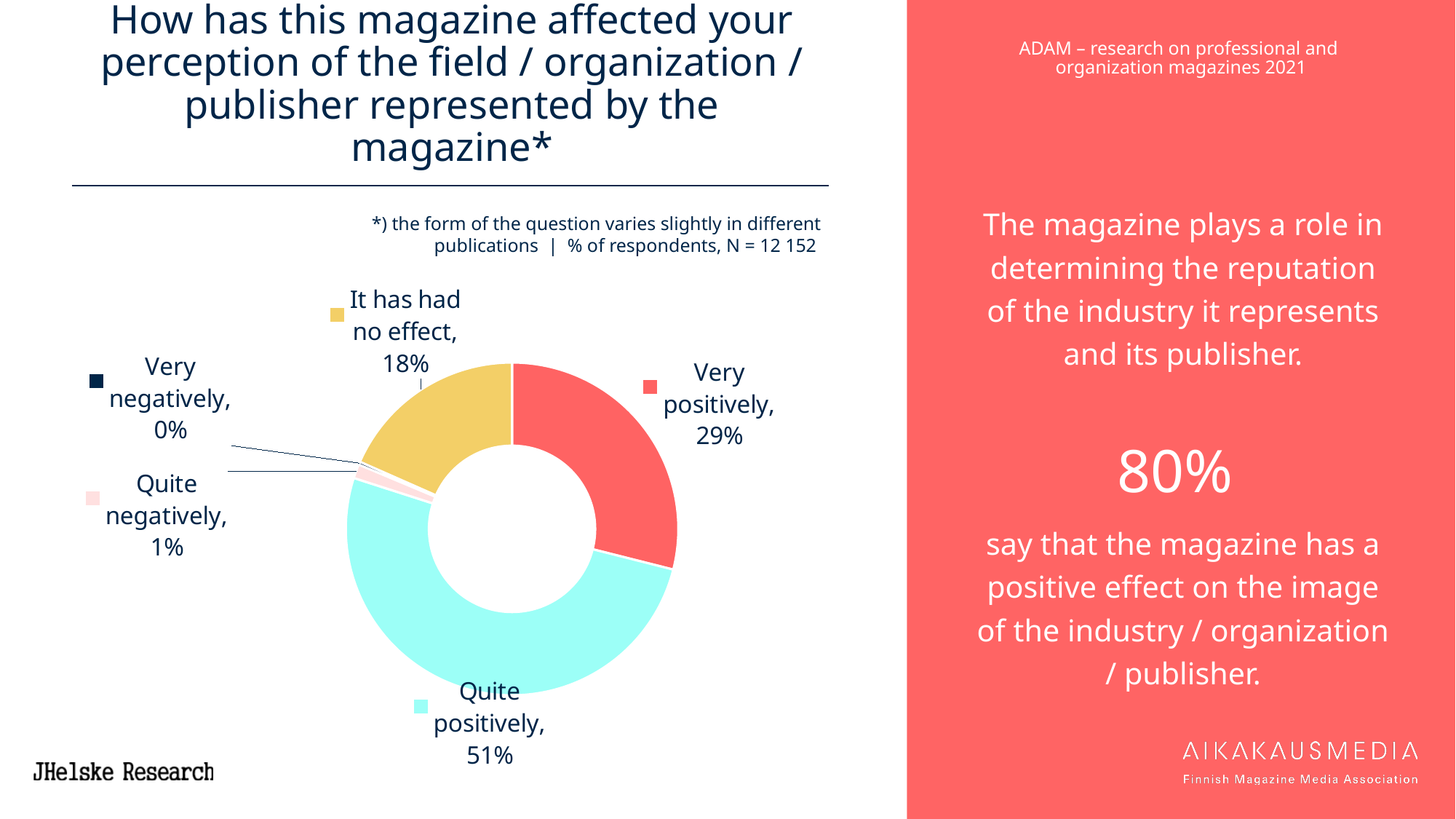
What is the number of respondents (N) stated for the chart? 12 152 What percentage of respondents said the magazine affected their perception quite positively? 51% Which response category has the smallest share of respondents? Very negatively How many response categories are shown in the chart? 5 What percentage of respondents said the magazine affected their perception very positively? 29% Which is larger: the share for 'It has had no effect' or the share for 'Very positively'? Very positively What is the difference in percentage points between 'Quite positively' and 'Very positively'? 22 Which response category has the largest share of respondents? Quite positively What share of respondents said the magazine has had no effect? 18% What is the combined share of respondents who answered 'Very positively' or 'Quite positively'? 80% What type of chart is used on the slide? Doughnut (pie) chart What percentage of respondents answered 'Quite negatively'? 1%